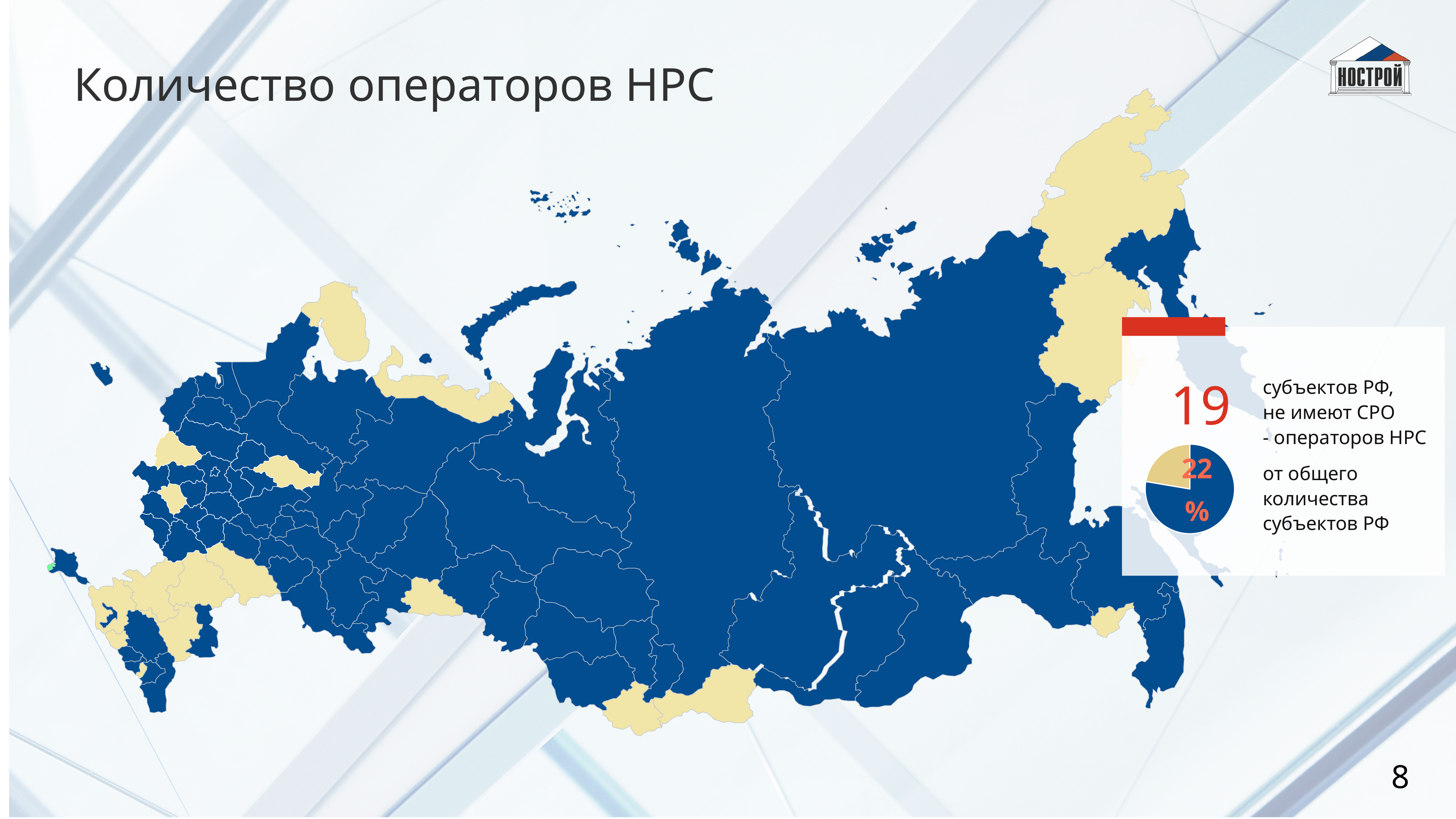
What percentage is printed on the pie chart? 22% What number is printed in red next to the pie chart, giving the count of subjects of the RF without SRO operators of NRS? 19 What kind of chart is shown in the panel on the right of the slide? pie chart Which slice of the pie chart is the smallest? the yellow slice (22%) What share of the pie does the yellow (light) slice represent? 22% What is the title of the slide containing the pie chart? Количество операторов НРС Which slice of the pie chart is larger, the blue one or the yellow one? the blue one How many slices does the pie chart have? 2